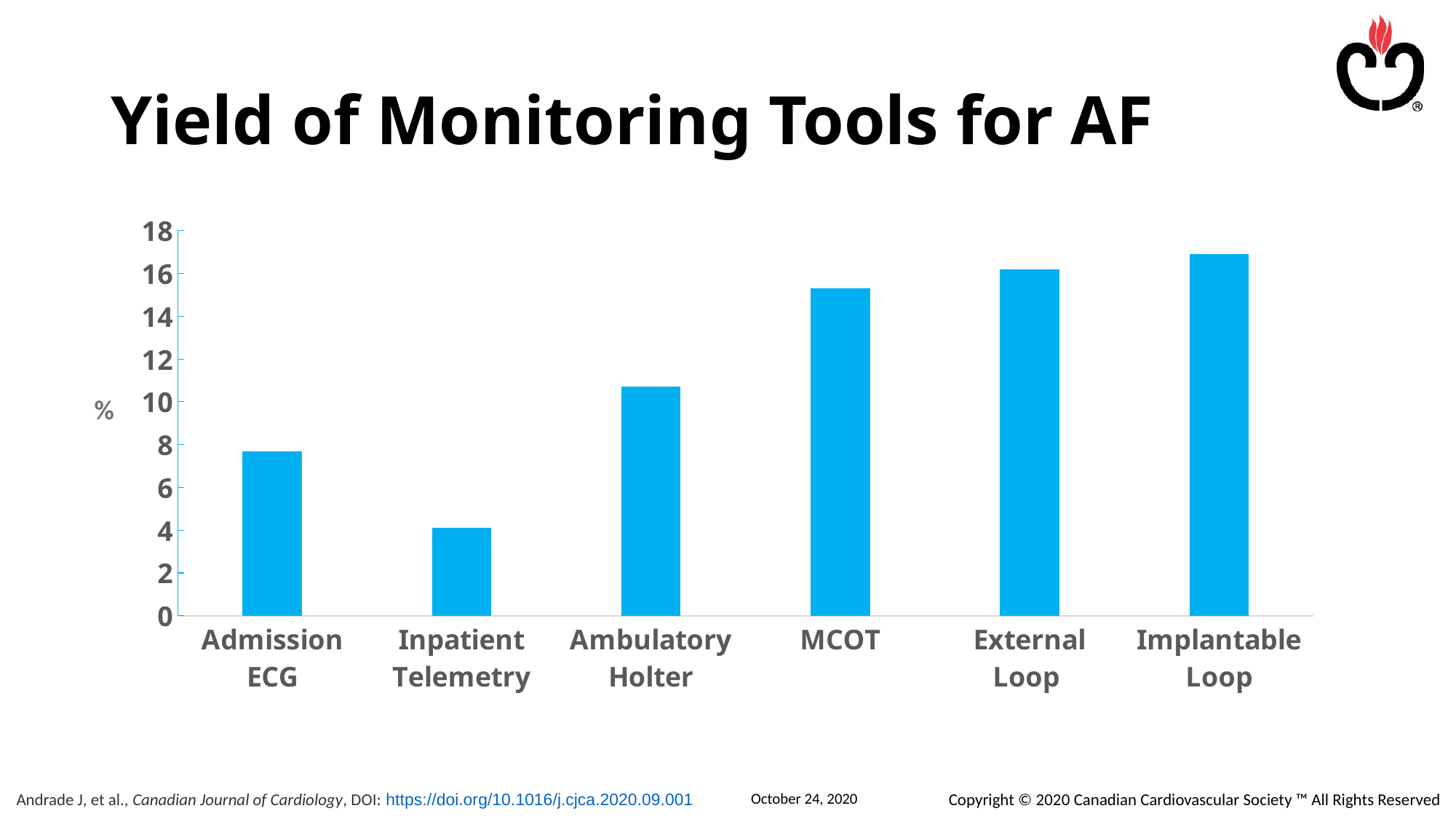
Which monitoring tool has the highest yield on the chart? Implantable Loop What type of chart is shown on the slide? bar chart Which has a higher yield, MCOT or Ambulatory Holter? MCOT Is the value for Ambulatory Holter greater or less than 12? less How many monitoring tools (categories) are plotted on the chart? 6 Which monitoring tool has the lowest yield on the chart? Inpatient Telemetry Is the value for Inpatient Telemetry greater or less than 6? less Is the value for Implantable Loop greater or less than 16? greater What is the title of the chart on the slide? Yield of Monitoring Tools for AF Which has a higher yield, Admission ECG or Inpatient Telemetry? Admission ECG